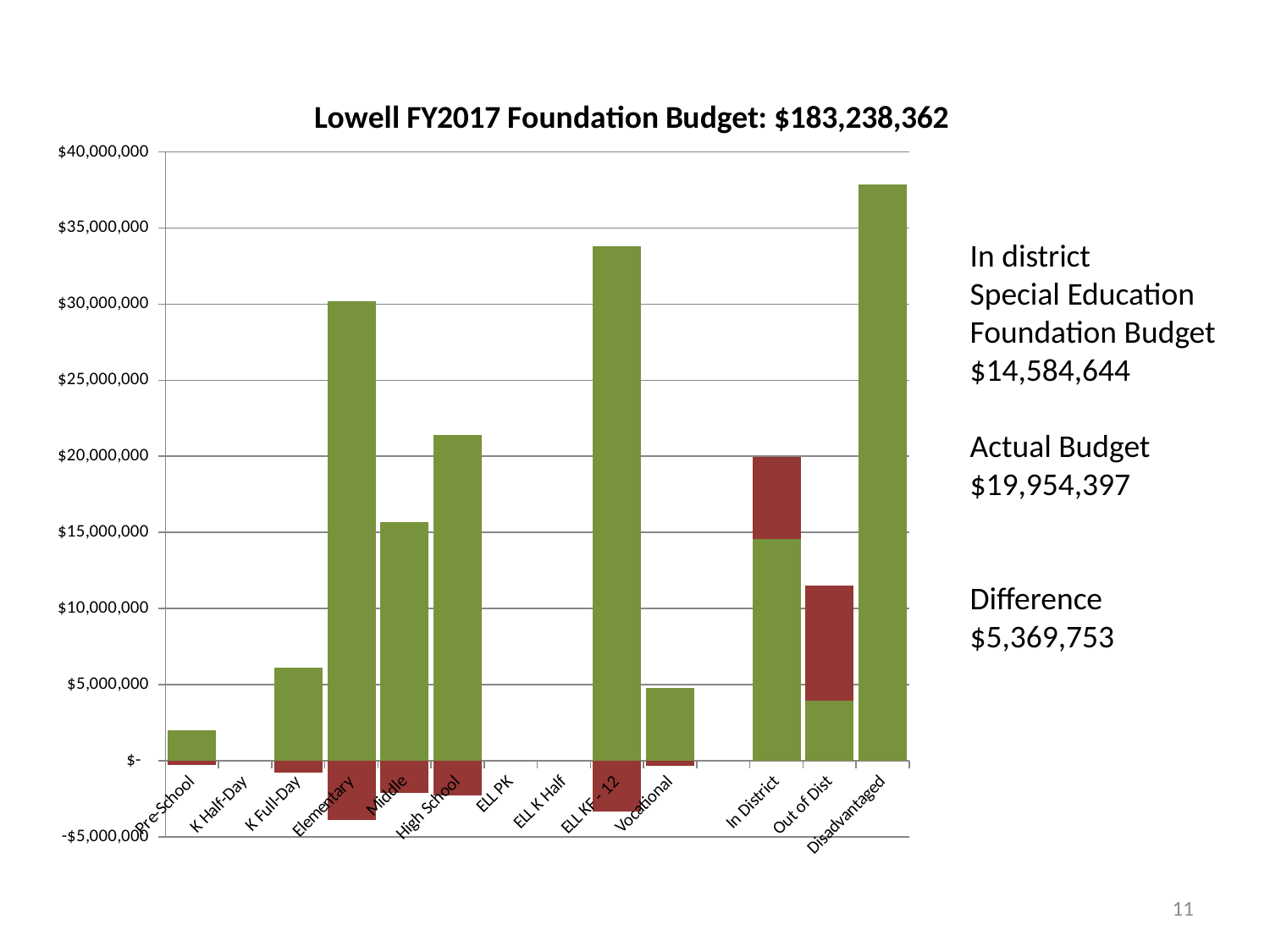
Is the green bar for High School greater or less than $20,000,000? greater Is the top of the stacked bar for Out of Dist greater or less than $15,000,000? less What is the title of the chart? Lowell FY2017 Foundation Budget: $183,238,362 Is the green bar for Elementary greater or less than $25,000,000? greater How many colours of bar segments are plotted in the chart? 2 Which has the taller green bar, ELL K - 12 or Elementary? ELL K - 12 Which category has the tallest green bar? Disadvantaged Which has the taller green bar, Elementary or High School? Elementary What kind of chart is shown on the slide? bar chart